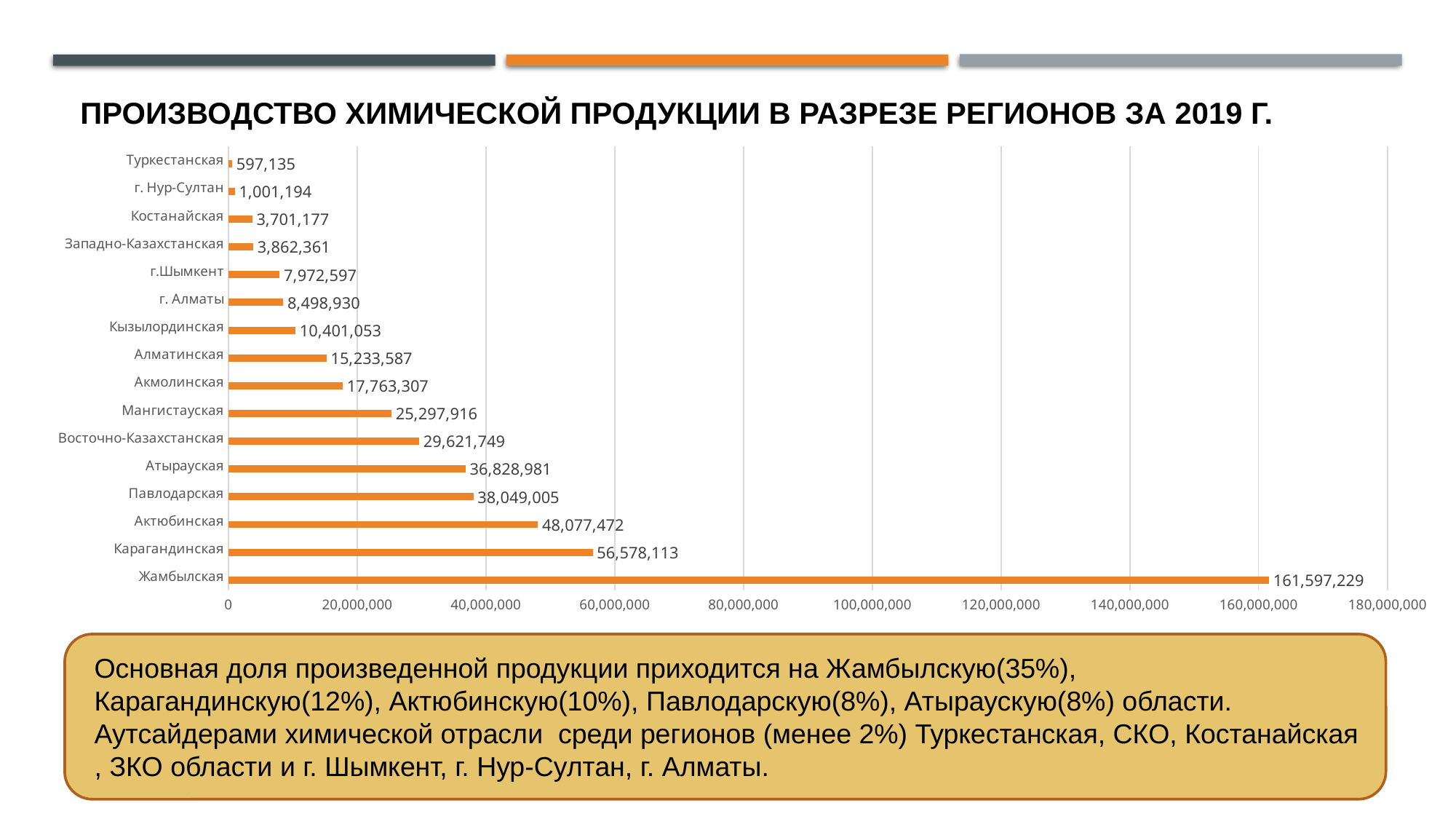
What is the difference between the values for Карагандинская and Актюбинская? 8,500,641 What is the value for Мангистауская? 25,297,916 Is the value for Восточно-Казахстанская greater or less than 20,000,000? greater Which is larger, the value for Павлодарская or the value for Атырауская? Павлодарская What is the value for Жамбылская? 161,597,229 Which region has the lowest value? Туркестанская How many regions are shown in the chart? 16 What is the value for Карагандинская? 56,578,113 What is the value for г. Нур-Султан? 1,001,194 Which region has the highest value? Жамбылская What type of chart is shown on the slide? bar chart What is the title of the chart? ПРОИЗВОДСТВО ХИМИЧЕСКОЙ ПРОДУКЦИИ В РАЗРЕЗЕ РЕГИОНОВ ЗА 2019 Г.